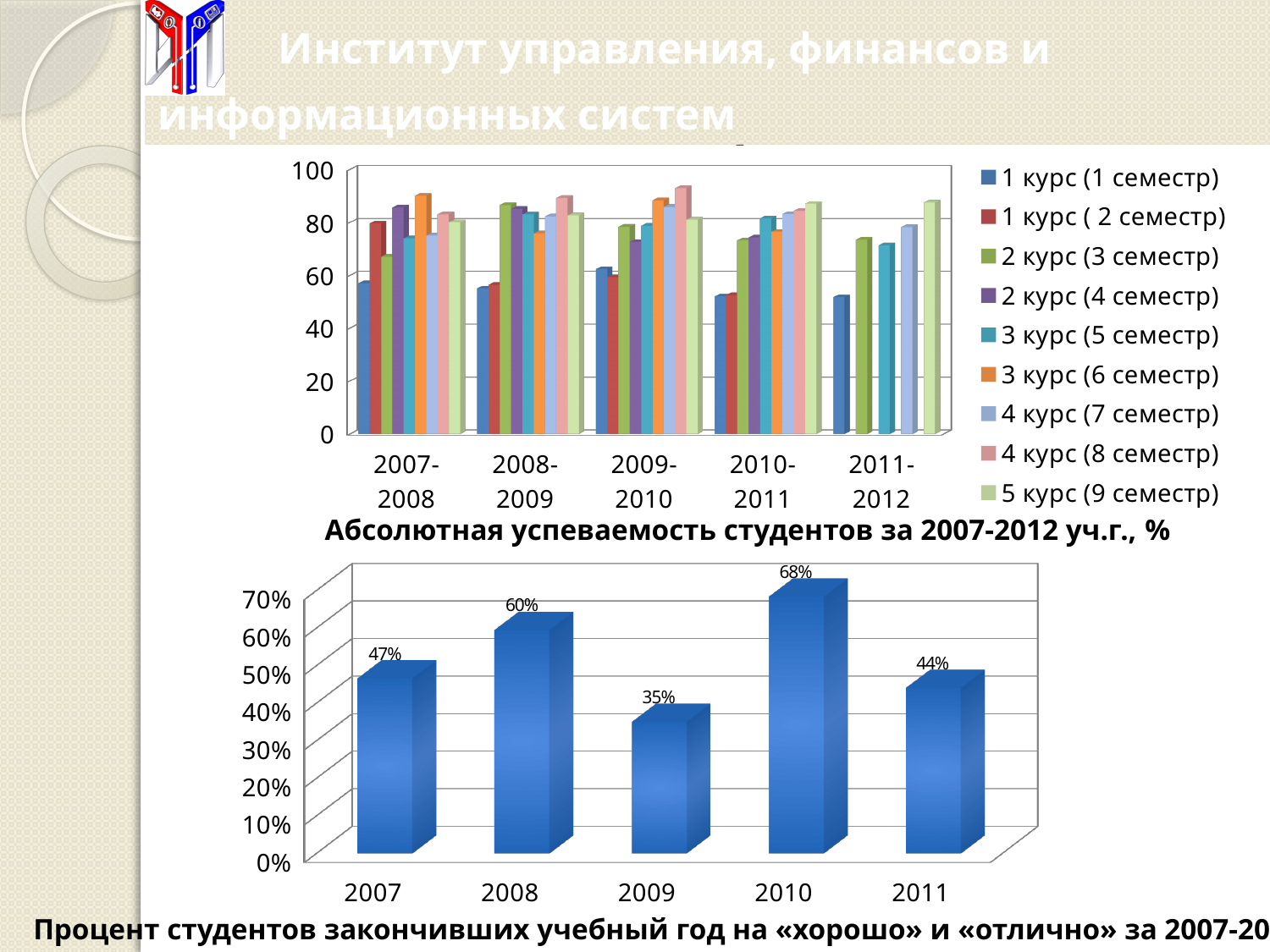
In the top chart, how many academic-year categories are shown on the x axis? 5 In the bottom chart, what is the difference between the values for 2010 and 2009? 33% In the bottom chart, what is the value for 2010? 68% In the bottom chart, what is the value for 2009? 35% In the top chart, is the value for 5 курс (9 семестр) in 2011-2012 greater or less than 80? greater In the bottom chart, which year has the highest value? 2010 In the bottom chart, how many years are shown on the x axis? 5 In the top chart, is the value for 1 курс (1 семестр) in 2007-2008 greater or less than 40? greater What kind of chart is the bottom chart? bar chart In the bottom chart, which year has the lowest value? 2009 In the bottom chart, which is larger, the value for 2007 or the value for 2011? 2007 In the top chart, how many series does the legend list? 9